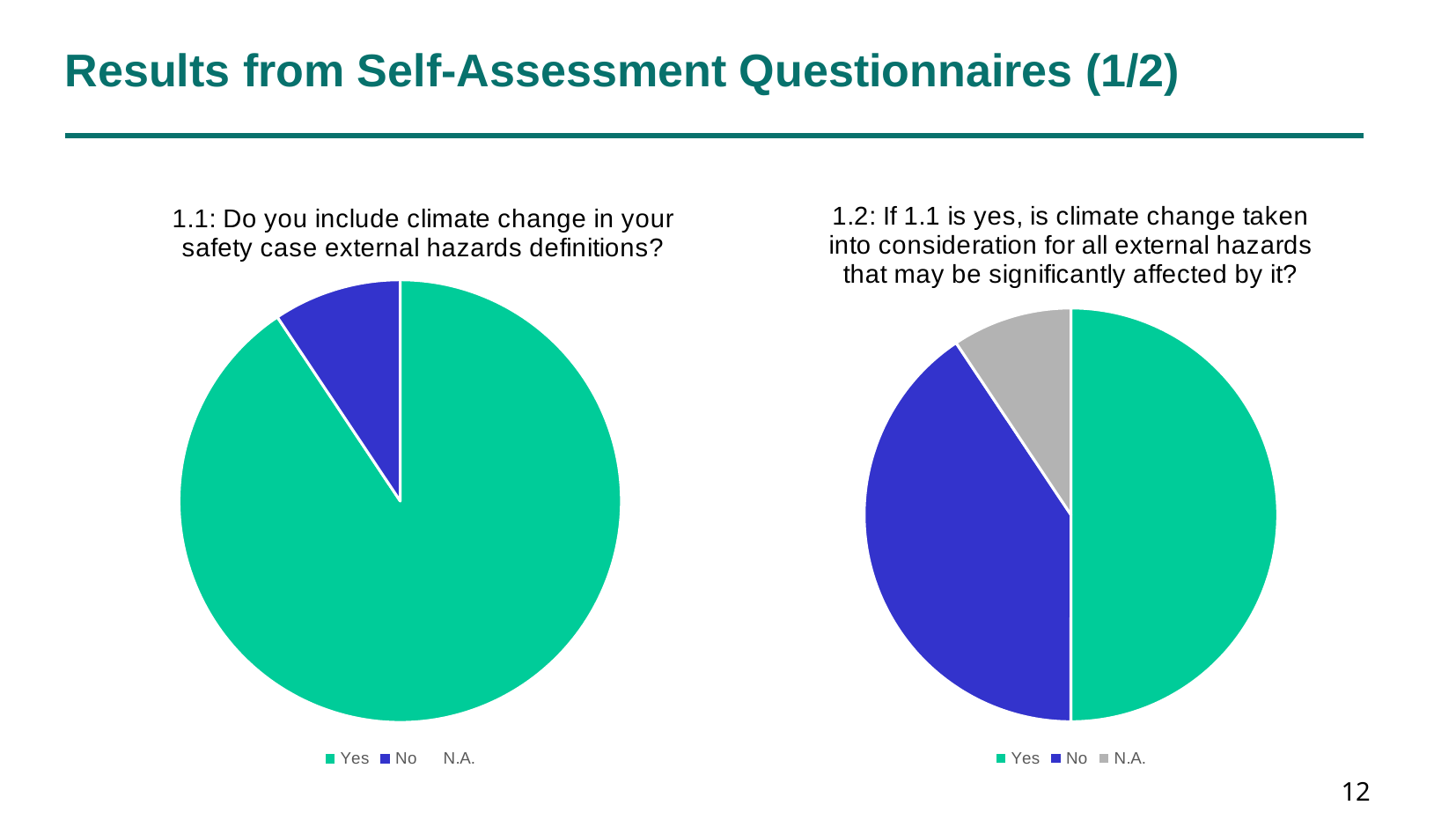
What kind of chart is the right chart (1.2)? pie chart In the right chart (1.2), which slice is larger, No or N.A.? No What kind of chart is the left chart (1.1)? pie chart In the right chart (1.2), which response has the largest slice? Yes In the right chart (1.2), which response has the smallest slice? N.A. In the right chart (1.2), which slice is larger, Yes or No? Yes In the right chart (1.2), what colour is the N.A. slice? grey In the left chart (1.1), which response has the largest slice? Yes How many slices are visible in the right chart (1.2)? 3 What is the title of the left chart? 1.1: Do you include climate change in your safety case external hazards definitions? How many entries does the legend of the left chart (1.1) list? 3 In the left chart (1.1), which slice is larger, Yes or No? Yes